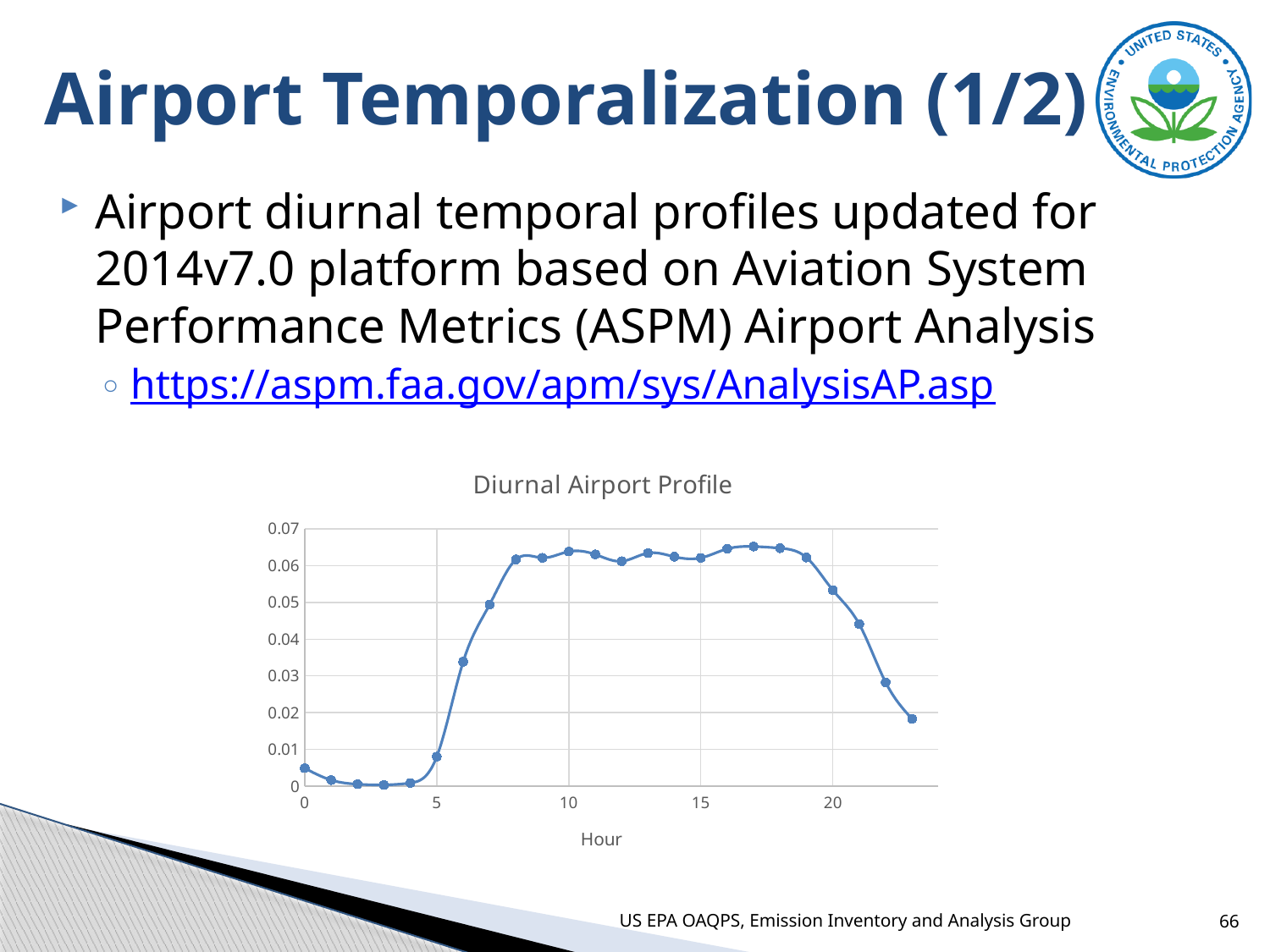
Do the values rise or fall from hour 19 to hour 23? fall What is the label of the x axis of the chart? Hour Is the value at hour 6 greater or less than 0.03? greater How many data points are plotted on the Diurnal Airport Profile chart? 24 Do the values rise or fall from hour 4 to hour 8? rise Is the value at hour 21 greater or less than 0.05? less What is the title of the chart on the slide? Diurnal Airport Profile What kind of chart is the Diurnal Airport Profile? line chart Is the value at hour 0 greater or less than 0.01? less Which is larger, the value at hour 5 or the value at hour 10? hour 10